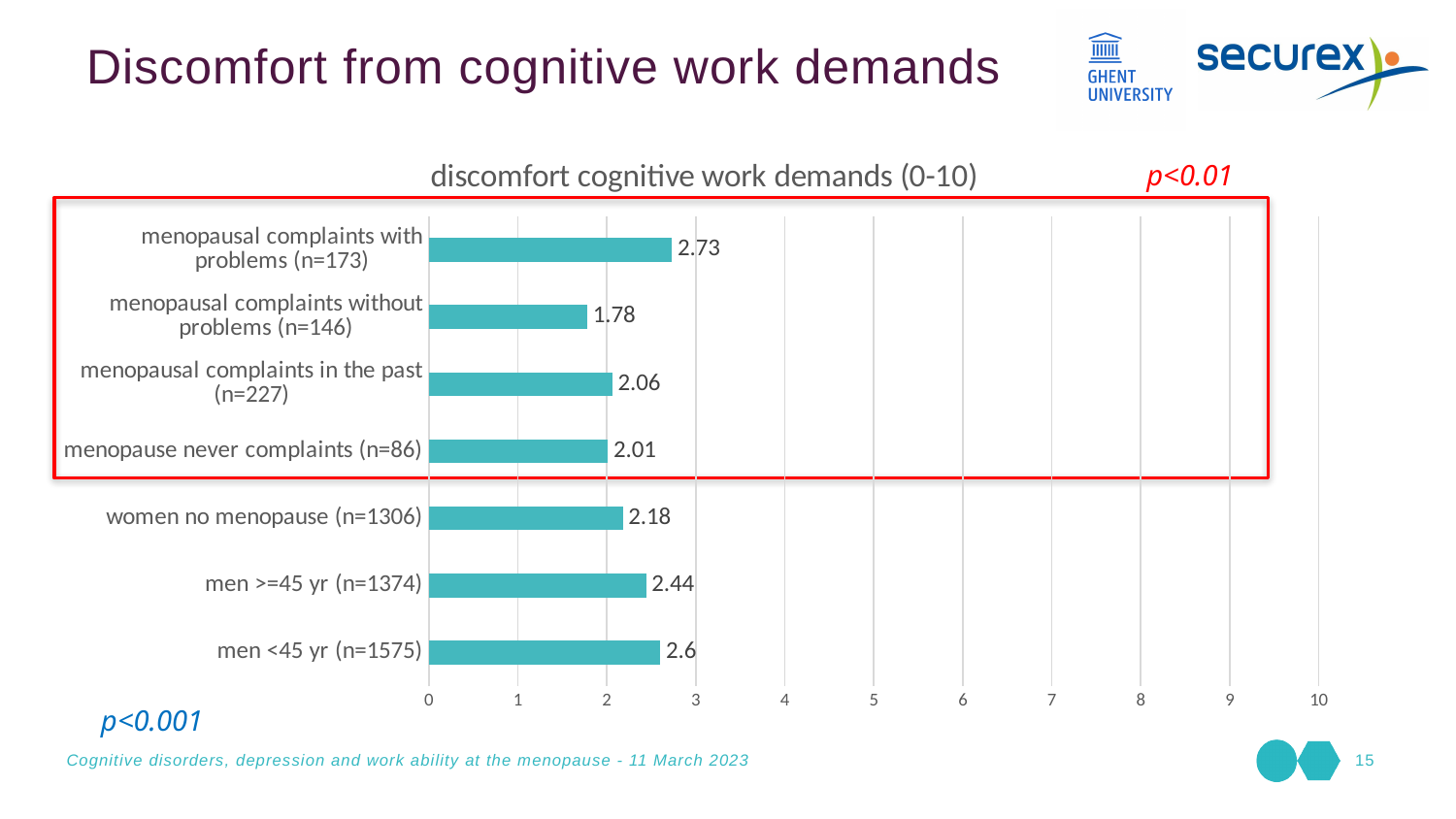
What is the title of the chart? discomfort cognitive work demands (0-10) What is the value for men <45 yr (n=1575)? 2.6 Which is larger, the value for men >=45 yr (n=1374) or the value for women no menopause (n=1306)? men >=45 yr (n=1374) What is the value for menopausal complaints with problems (n=173)? 2.73 Which category has the highest value? menopausal complaints with problems (n=173) What kind of chart is shown on the slide? bar chart What is the value for women no menopause (n=1306)? 2.18 How many categories are shown in the chart? 7 What is the difference between the values for menopausal complaints with problems (n=173) and menopausal complaints without problems (n=146)? 0.95 Is the value for menopausal complaints in the past (n=227) greater or less than 3? less Which category has the lowest value? menopausal complaints without problems (n=146) What is the maximum value shown on the x axis? 10